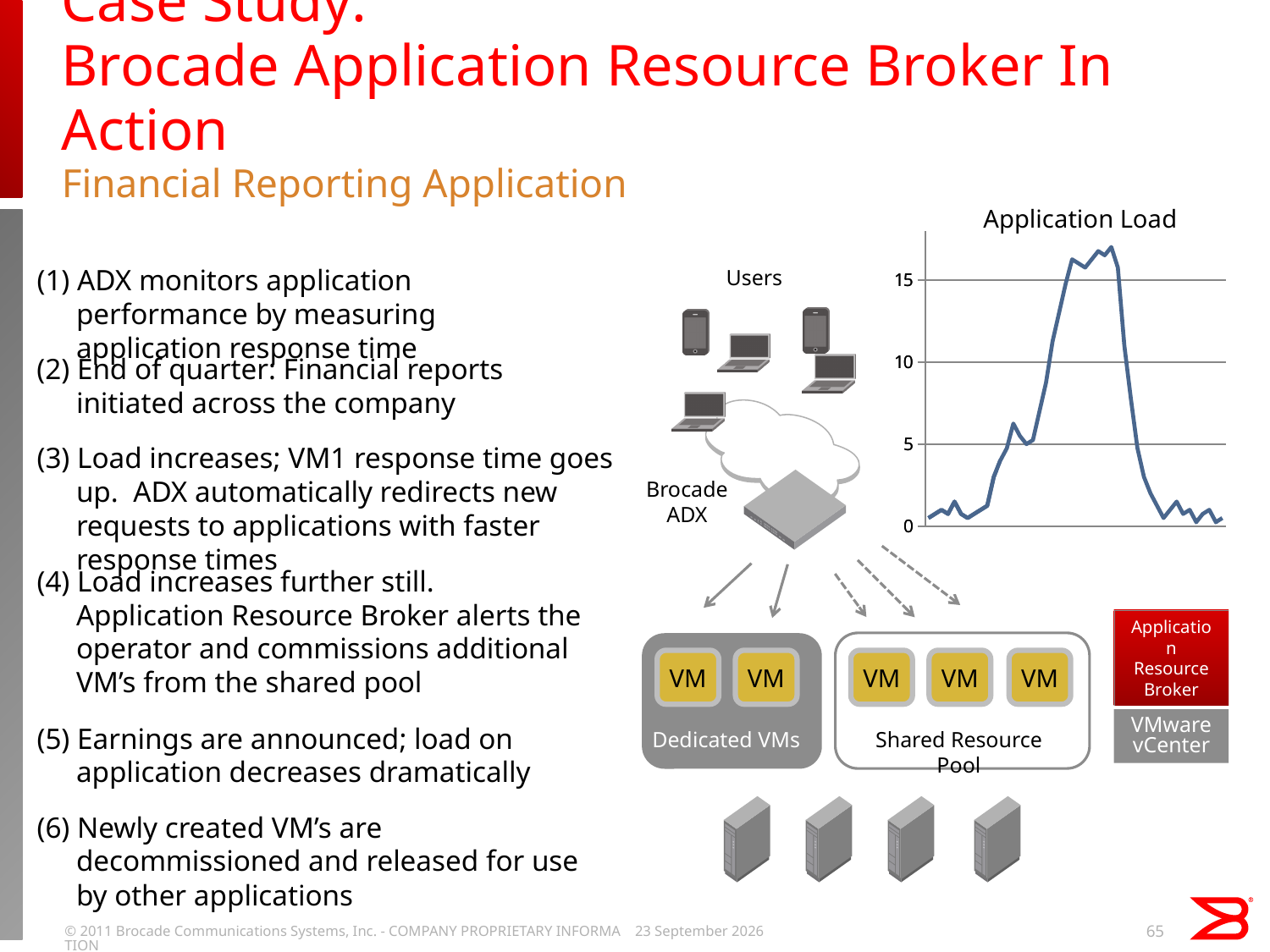
What is the highest tick value shown on the y axis of the Application Load chart? 15 Is the value at the peak of the Application Load line greater or less than 10? greater How many lines are plotted in the Application Load chart? 1 Is the value at the start of the Application Load line greater or less than 5? less Is the value at the end of the Application Load line greater or less than 5? less What is the title of the chart on the slide? Application Load In the Application Load chart, does the line rise or fall in the final portion of the x axis? fall In the Application Load chart, does the line rise or fall in the first half of the x axis? rise What kind of chart is shown on the right side of the slide? line chart